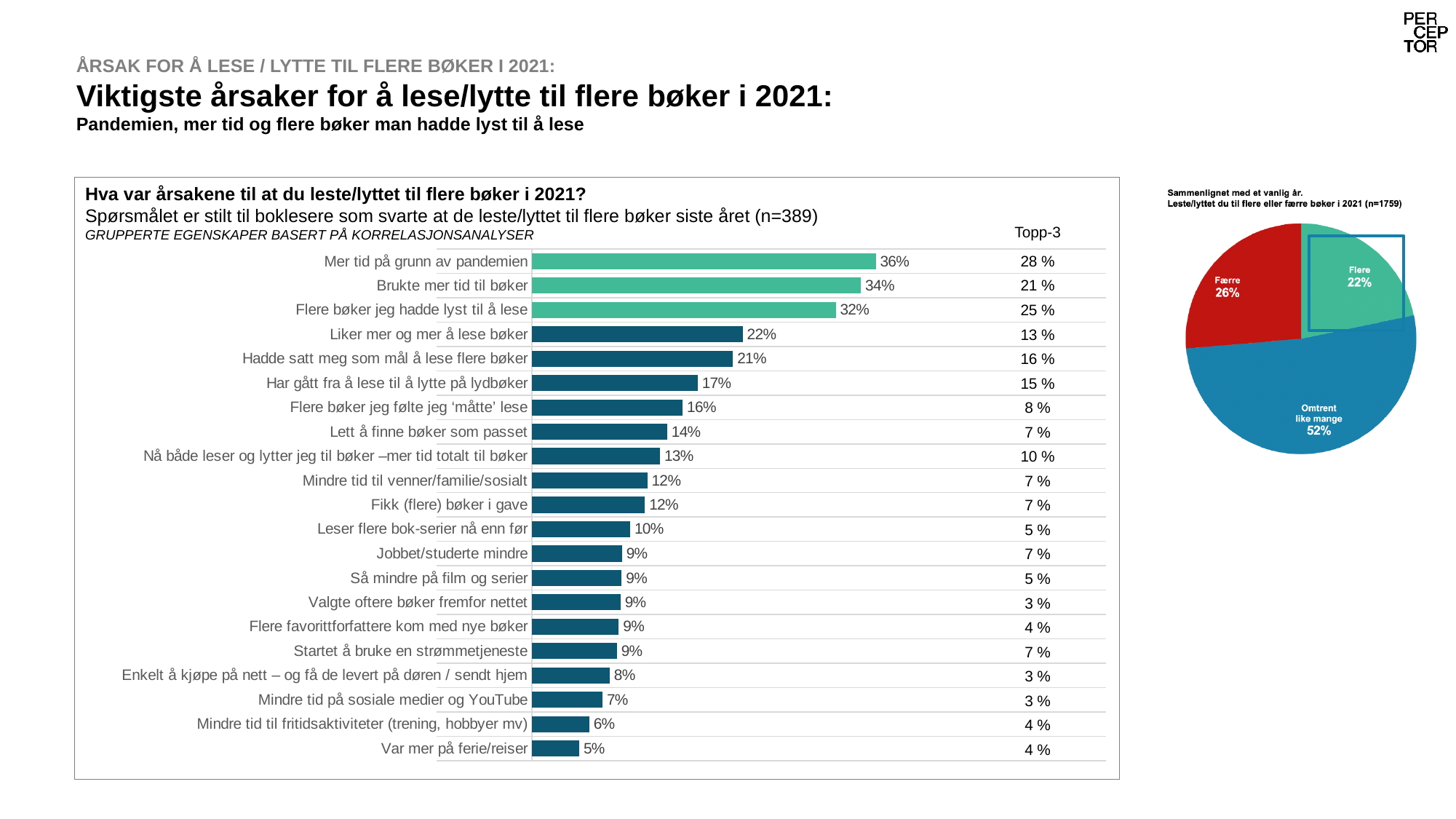
In the pie chart on the right, what share is 'Omtrent like mange'? 52% How many slices does the pie chart on the right have? 3 How many categories are shown in the bar chart on the left? 21 In the pie chart on the right, which slice is the smallest? Flere In the bar chart on the left, what is the Topp-3 value for 'Flere bøker jeg hadde lyst til å lese'? 25 % In the bar chart on the left, which category has the lowest value? Var mer på ferie/reiser In the bar chart on the left, which is larger: 'Lett å finne bøker som passet' or 'Leser flere bok-serier nå enn før'? Lett å finne bøker som passet In the bar chart on the left, what is the difference between 'Brukte mer tid til bøker' and 'Liker mer og mer å lese bøker'? 12% What kind of chart is the chart on the left of the slide? Bar chart In the bar chart on the left, what is the value for 'Har gått fra å lese til å lytte på lydbøker'? 17% In the bar chart on the left, which category has the highest value? Mer tid på grunn av pandemien In the bar chart on the left, what is the value for 'Mer tid på grunn av pandemien'? 36%